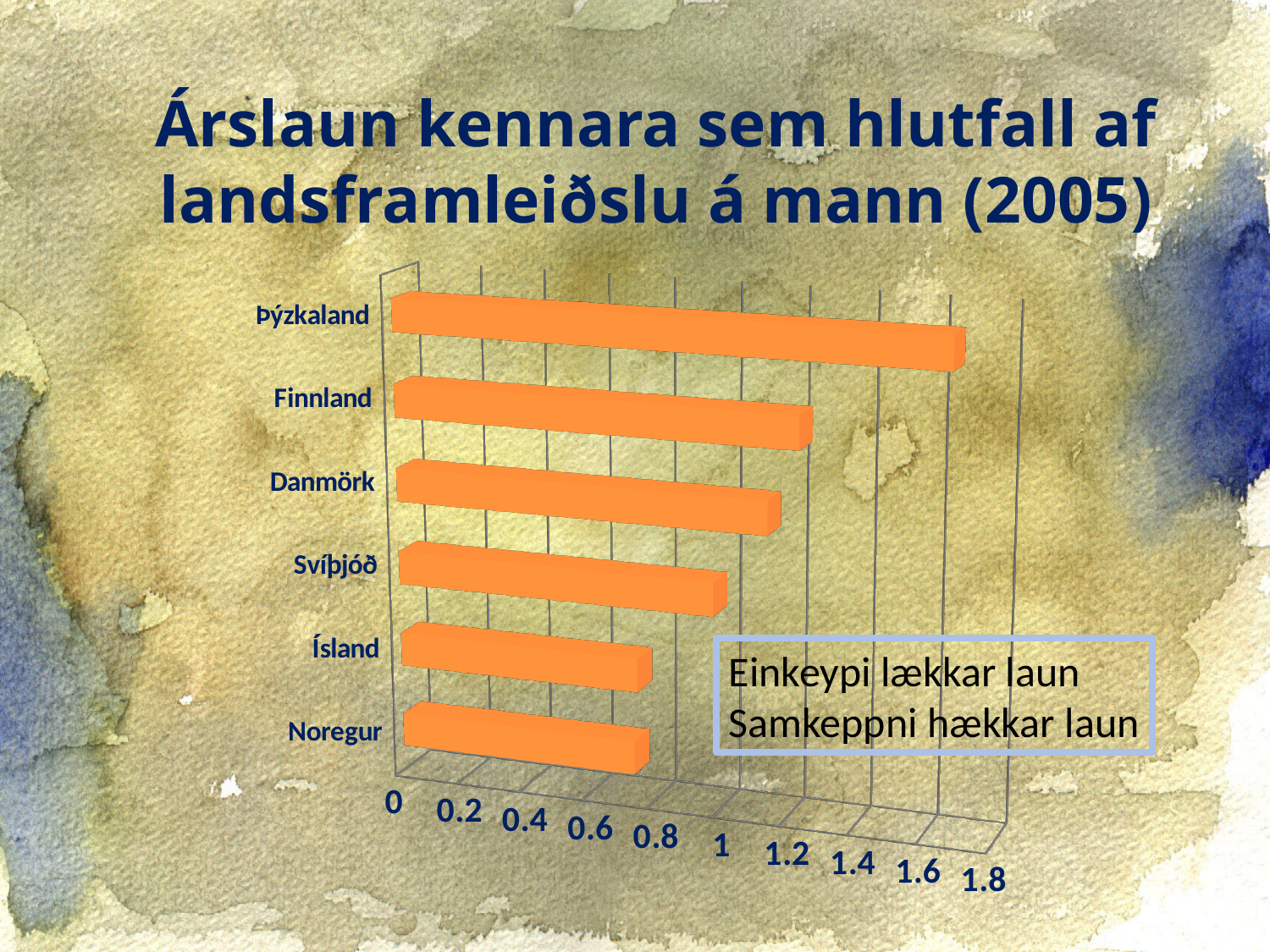
What kind of chart is shown on the slide? bar chart Is the value for Finnland greater or less than 1? greater Which has the larger value, Þýzkaland or Finnland? Þýzkaland Which has the larger value, Danmörk or Noregur? Danmörk Is the value for Ísland greater or less than 1? less How many countries are shown in the chart? 6 Is the value for Þýzkaland greater or less than 1.4? greater Which has the larger value, Finnland or Ísland? Finnland Which country has the highest value in the chart? Þýzkaland What is the title of the slide containing the chart? Árslaun kennara sem hlutfall af landsframleiðslu á mann (2005)